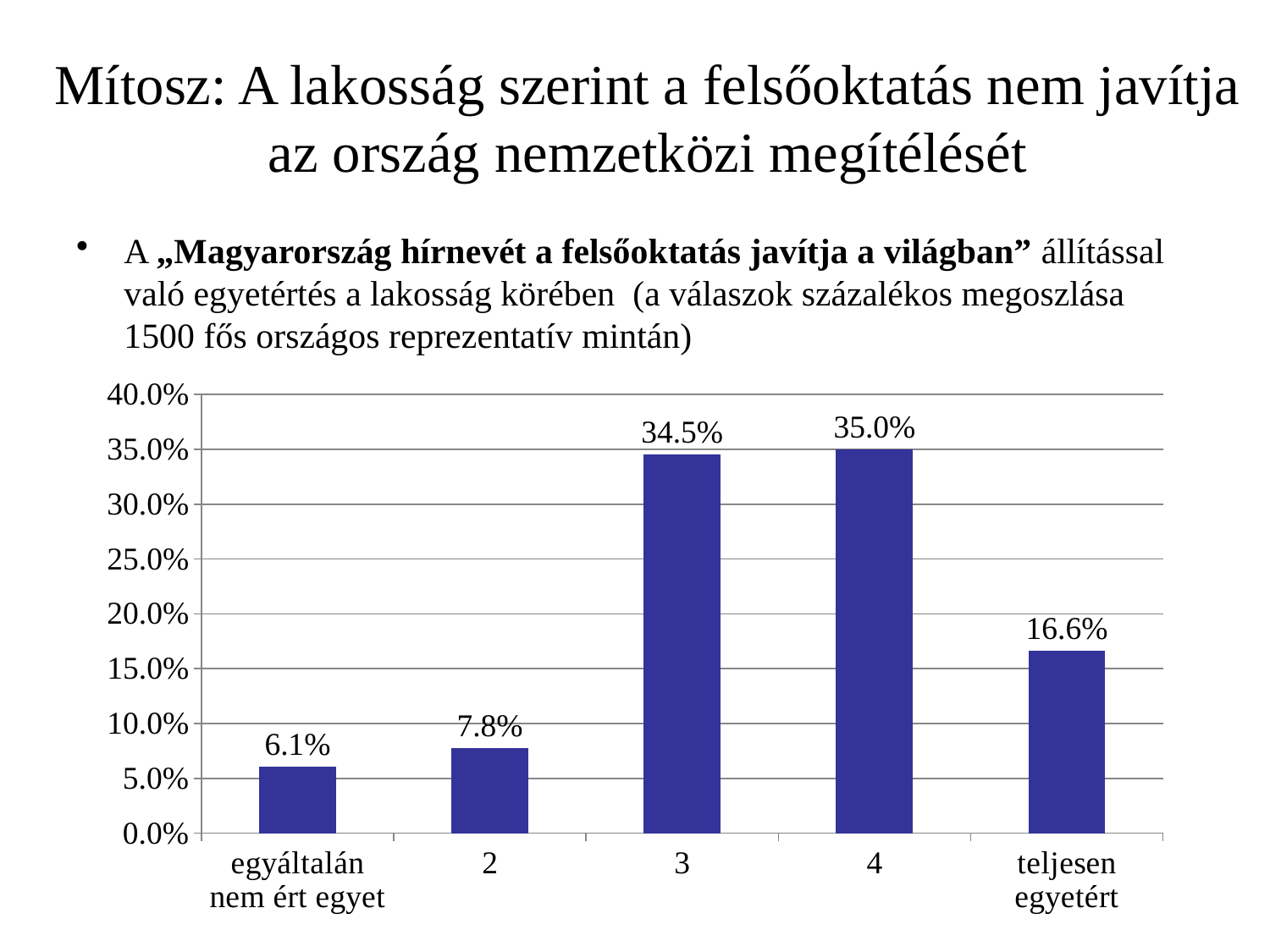
What is the value for category 3? 34.5% Is the value for category 3 greater or less than 30.0%? greater What is the highest value shown on the y axis? 40.0% What is the value for the category "egyáltalán nem ért egyet"? 6.1% What kind of chart is shown on the slide? bar chart What is the value for the category "teljesen egyetért"? 16.6% What is the difference between the values for category 4 and category 3? 0.5% How many categories are shown on the x axis? 5 Which category has the lowest value? egyáltalán nem ért egyet What is the difference between the values for "teljesen egyetért" and "egyáltalán nem ért egyet"? 10.5% Which category has the highest value? 4 Which is larger, the value for category 2 or the value for "teljesen egyetért"? teljesen egyetért